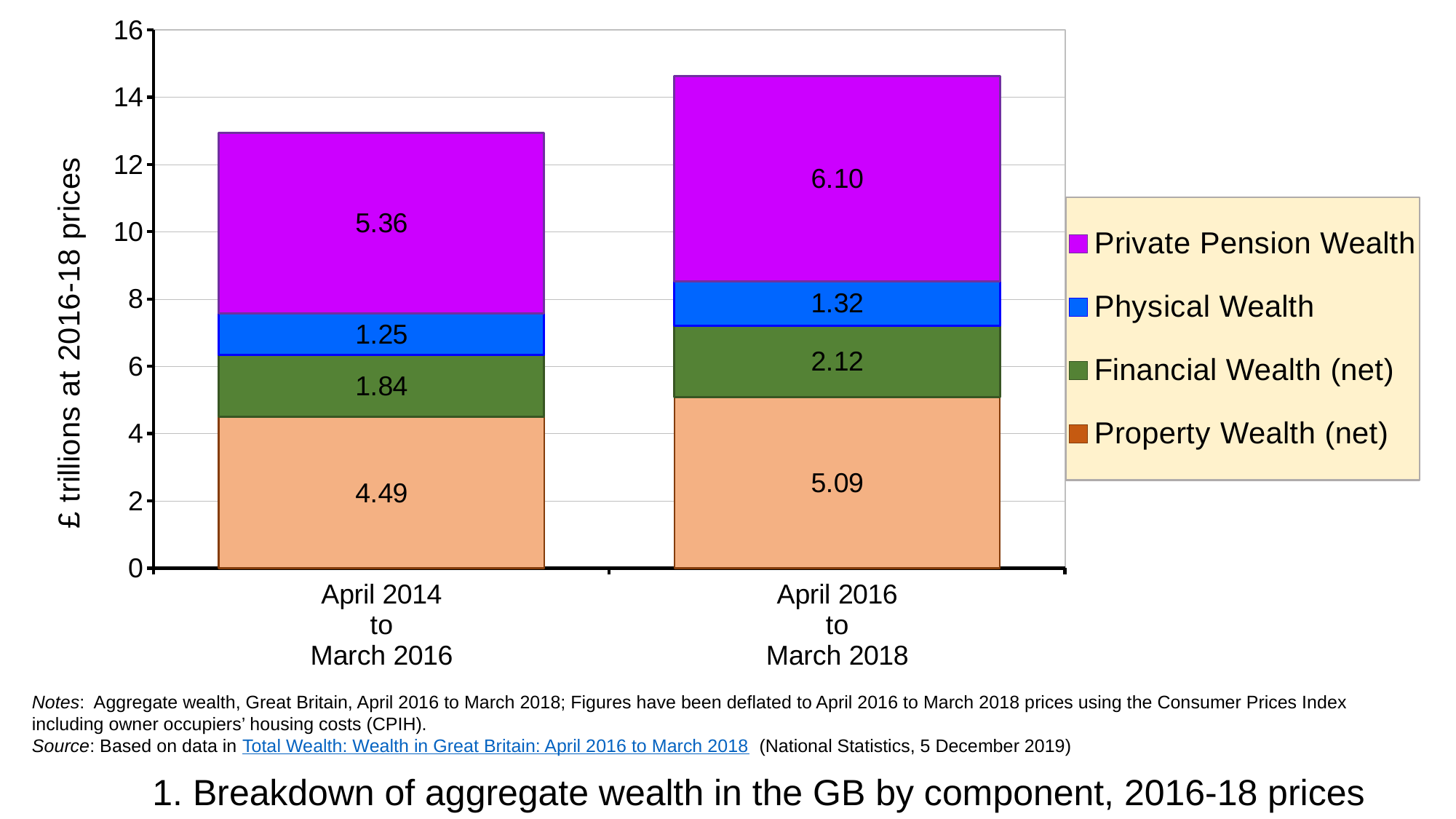
How many series does the legend list? 4 Which component is the smallest in the April 2014 to March 2016 bar? Physical Wealth What is the total of the stacked bar for April 2016 to March 2018? 14.63 What is the Private Pension Wealth value for April 2016 to March 2018? 6.10 Which period has the larger Property Wealth (net) value? April 2016 to March 2018 What is the difference in Private Pension Wealth between April 2016 to March 2018 and April 2014 to March 2016? 0.74 What is the Financial Wealth (net) value for April 2014 to March 2016? 1.84 What is the Physical Wealth value for April 2016 to March 2018? 1.32 Which component is the largest in the April 2016 to March 2018 bar? Private Pension Wealth What is the Property Wealth (net) value for April 2014 to March 2016? 4.49 What kind of chart is shown on the slide? Stacked bar chart What is the total of the stacked bar for April 2014 to March 2016? 12.94